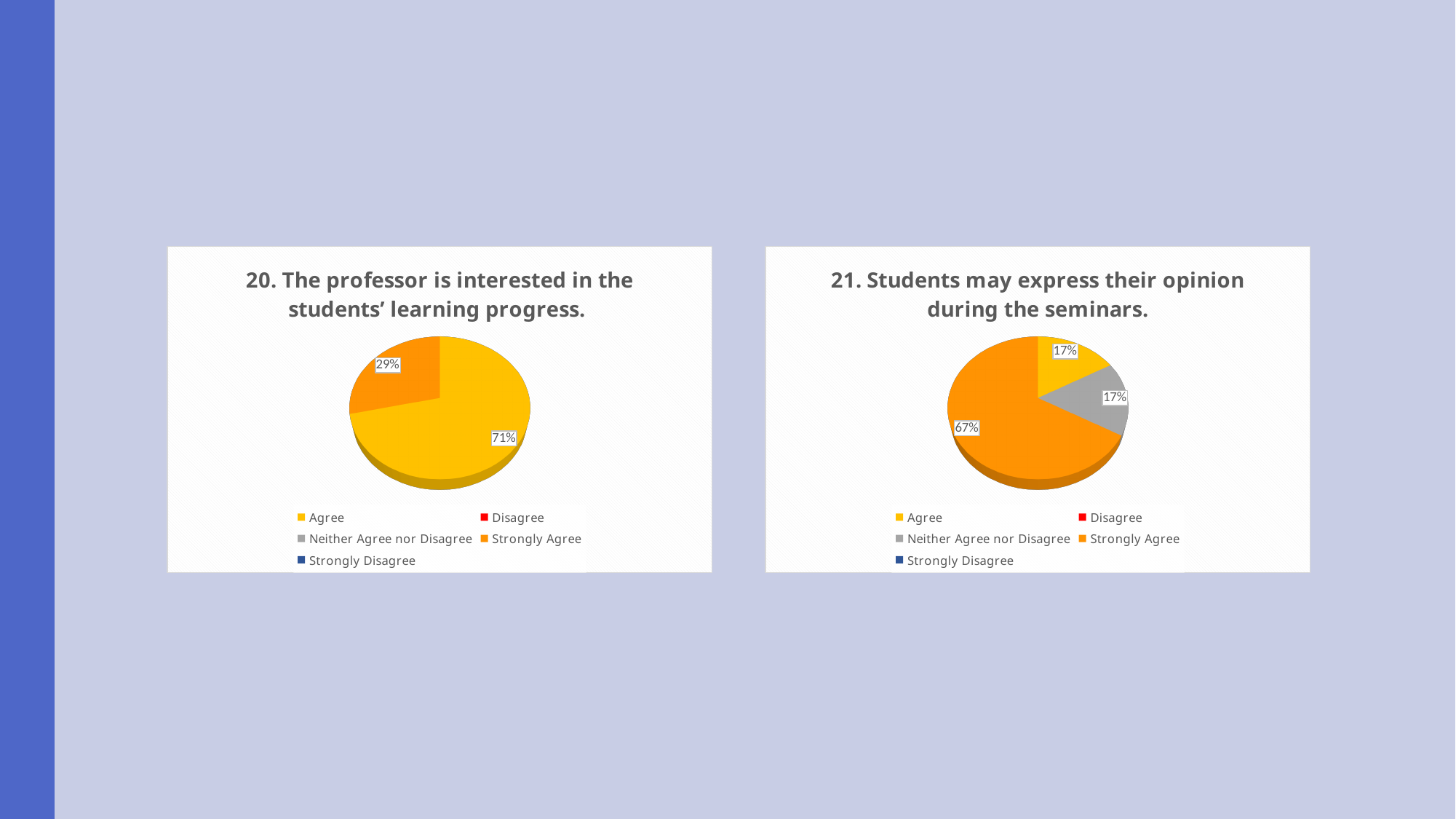
What kind of chart is the chart on the right of the slide? Pie chart In the chart titled "20. The professor is interested in the students' learning progress.", how many slices does the pie have? 2 In the chart titled "21. Students may express their opinion during the seminars.", which response has the largest slice? Strongly Agree How many entries does the legend of the chart on the left of the slide list? 5 In the chart titled "20. The professor is interested in the students' learning progress.", what is the difference between the Agree and Strongly Agree shares? 42% In the chart titled "21. Students may express their opinion during the seminars.", what is the difference between the Strongly Agree and Agree shares? 50% In the chart titled "21. Students may express their opinion during the seminars.", how many slices does the pie have? 3 In the chart titled "21. Students may express their opinion during the seminars.", what share of the pie is Strongly Agree? 67% In the chart titled "21. Students may express their opinion during the seminars.", what share of the pie is Neither Agree nor Disagree? 17% In the chart titled "20. The professor is interested in the students' learning progress.", what share of the pie is Agree? 71% In the chart titled "20. The professor is interested in the students' learning progress.", what share of the pie is Strongly Agree? 29% In the chart titled "20. The professor is interested in the students' learning progress.", which response has the largest slice? Agree